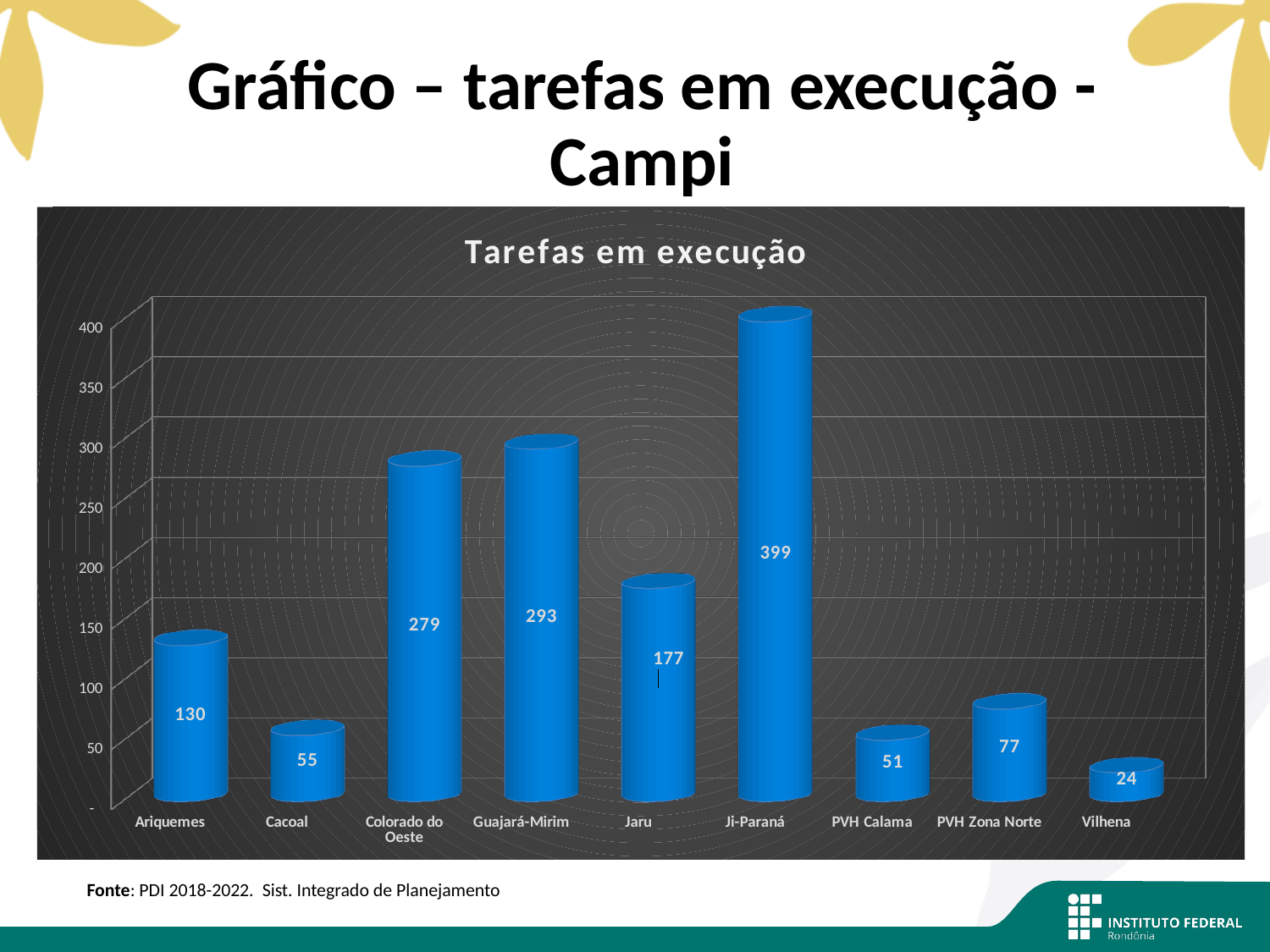
What is the title of the chart? Tarefas em execução What is the value for Ji-Paraná in the 'Tarefas em execução' chart? 399 Which campus has the highest number of tarefas em execução? Ji-Paraná Is the value for Jaru greater or less than 200? less What is the difference between the values for Guajará-Mirim and Colorado do Oeste? 14 What is the difference between the values for Ariquemes and Cacoal? 75 Which campus has the lowest number of tarefas em execução? Vilhena What is the value for Vilhena? 24 What is the value for Colorado do Oeste? 279 Which is larger, the value for Jaru or the value for PVH Zona Norte? Jaru What kind of chart is shown on the slide? bar chart How many campi are shown on the x axis of the chart? 9